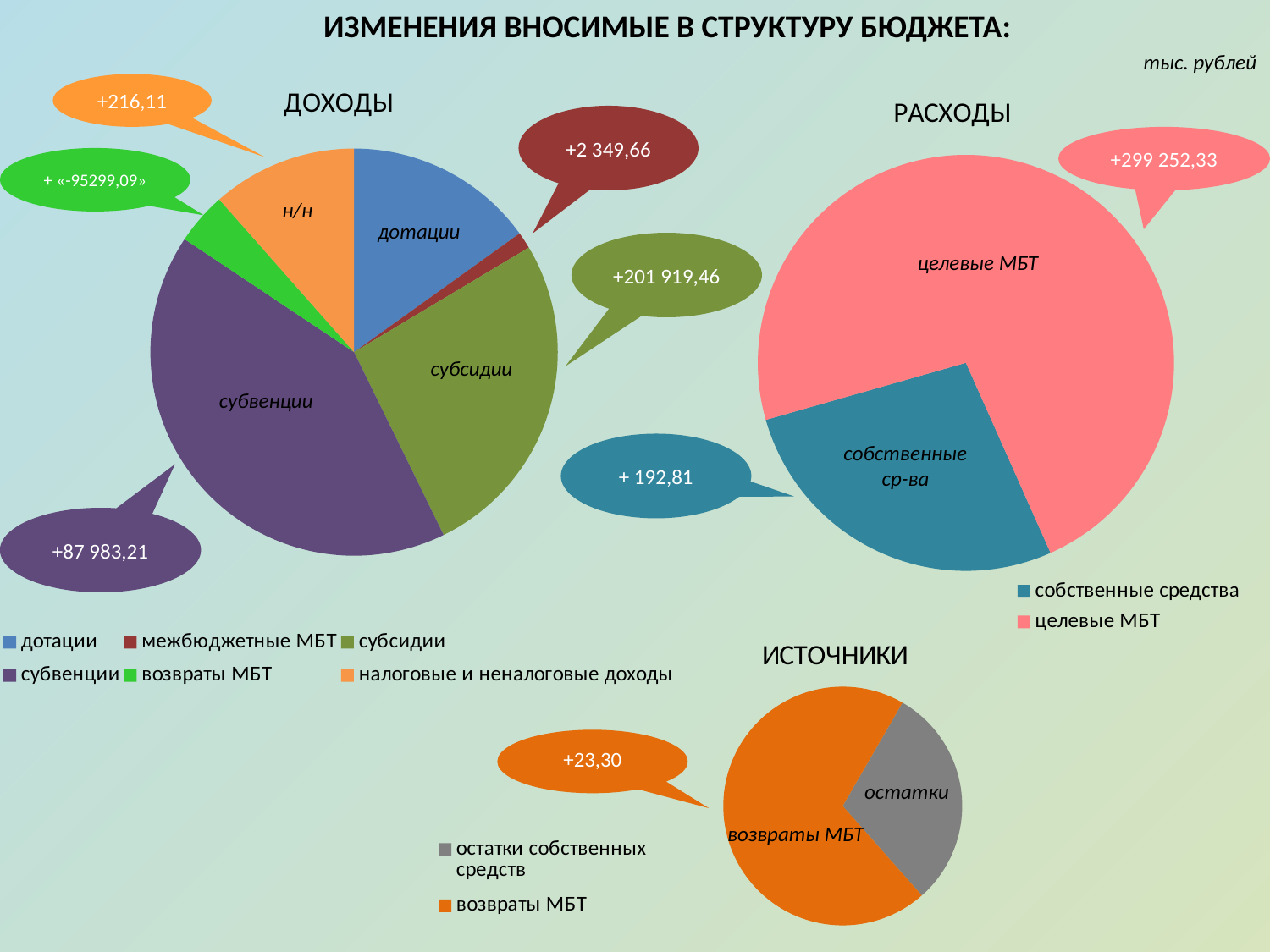
In the ДОХОДЫ chart, what change is shown in the callout pointing to the субвенции slice? +87 983,21 In the ДОХОДЫ chart, what change is shown in the orange callout pointing to the н/н slice? +216,11 In the ИСТОЧНИКИ chart, what change is shown in the callout pointing to the возвраты МБТ slice? +23,30 How many slices does the ДОХОДЫ pie chart have according to its legend? 6 How many entries does the legend of the ИСТОЧНИКИ chart list? 2 Which slice is larger in the РАСХОДЫ pie chart, целевые МБТ or собственные ср-ва? целевые МБТ Which slice is the largest in the ИСТОЧНИКИ pie chart? возвраты МБТ In the РАСХОДЫ chart, what change is shown in the callout pointing to the целевые МБТ slice? +299 252,33 Which slice is the smallest in the ДОХОДЫ pie chart? межбюджетные МБТ In the ДОХОДЫ chart, what change is shown in the callout pointing to the субсидии slice? +201 919,46 Which slice is the largest in the ДОХОДЫ pie chart? субвенции What kind of chart is the ДОХОДЫ chart? pie chart